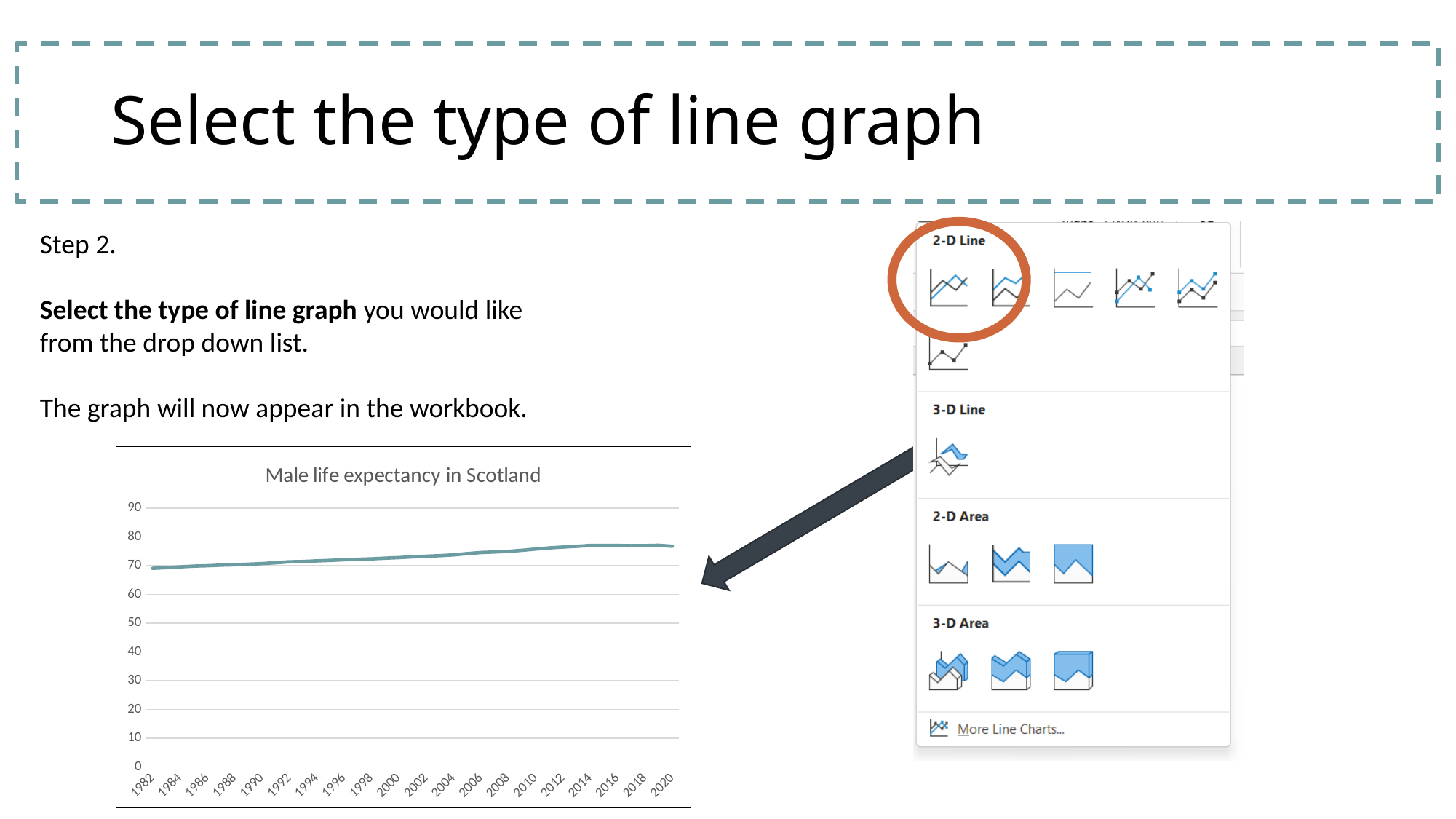
Which is larger, the value for 1982 or the value for 2020? 2020 What kind of chart is shown on the slide? line chart How many lines are plotted on the chart? 1 Which year has the lowest value on the chart? 1982 Is the value for 2020 greater or less than 70? greater How many year labels are shown on the x axis of the chart? 20 Does the line in the chart rise or fall from 1982 to 2020? rise Is the value for 2020 greater or less than 80? less Is the value for 1982 greater or less than 80? less What is the title of the chart on the slide? Male life expectancy in Scotland What is the highest value labelled on the y axis of the chart? 90